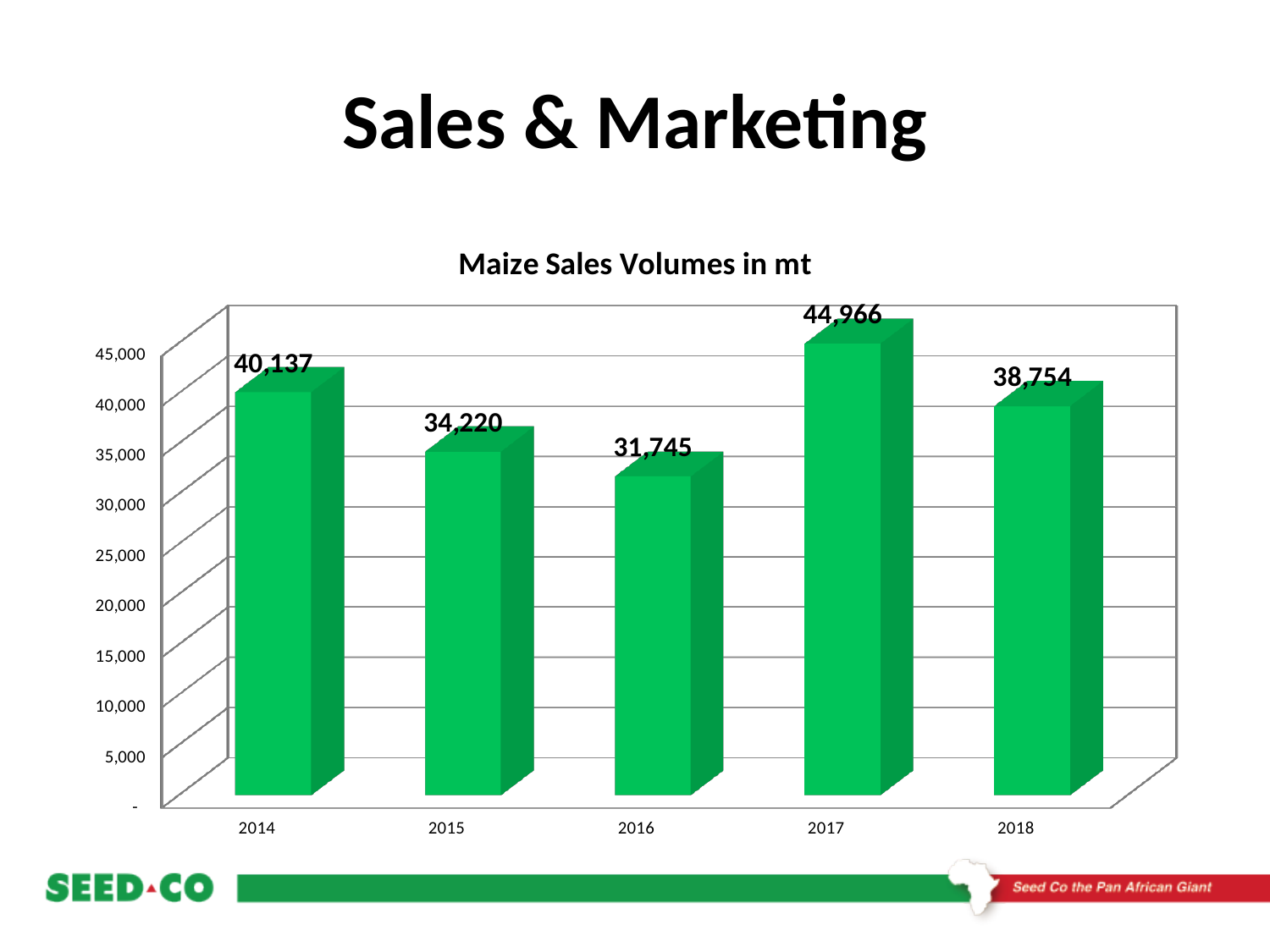
How many years are shown on the chart? 5 What is the title of the chart? Maize Sales Volumes in mt Is the maize sales volume for 2015 greater or less than 35,000? less What is the difference in maize sales volume between 2014 and 2015? 5,917 What is the maize sales volume for 2014? 40,137 Which year has the highest maize sales volume? 2017 What is the difference in maize sales volume between 2017 and 2016? 13,221 What is the maize sales volume for 2017? 44,966 What is the maize sales volume for 2016? 31,745 What kind of chart is shown on the slide? Bar chart Which year has the lowest maize sales volume? 2016 Which year had a larger maize sales volume, 2015 or 2018? 2018